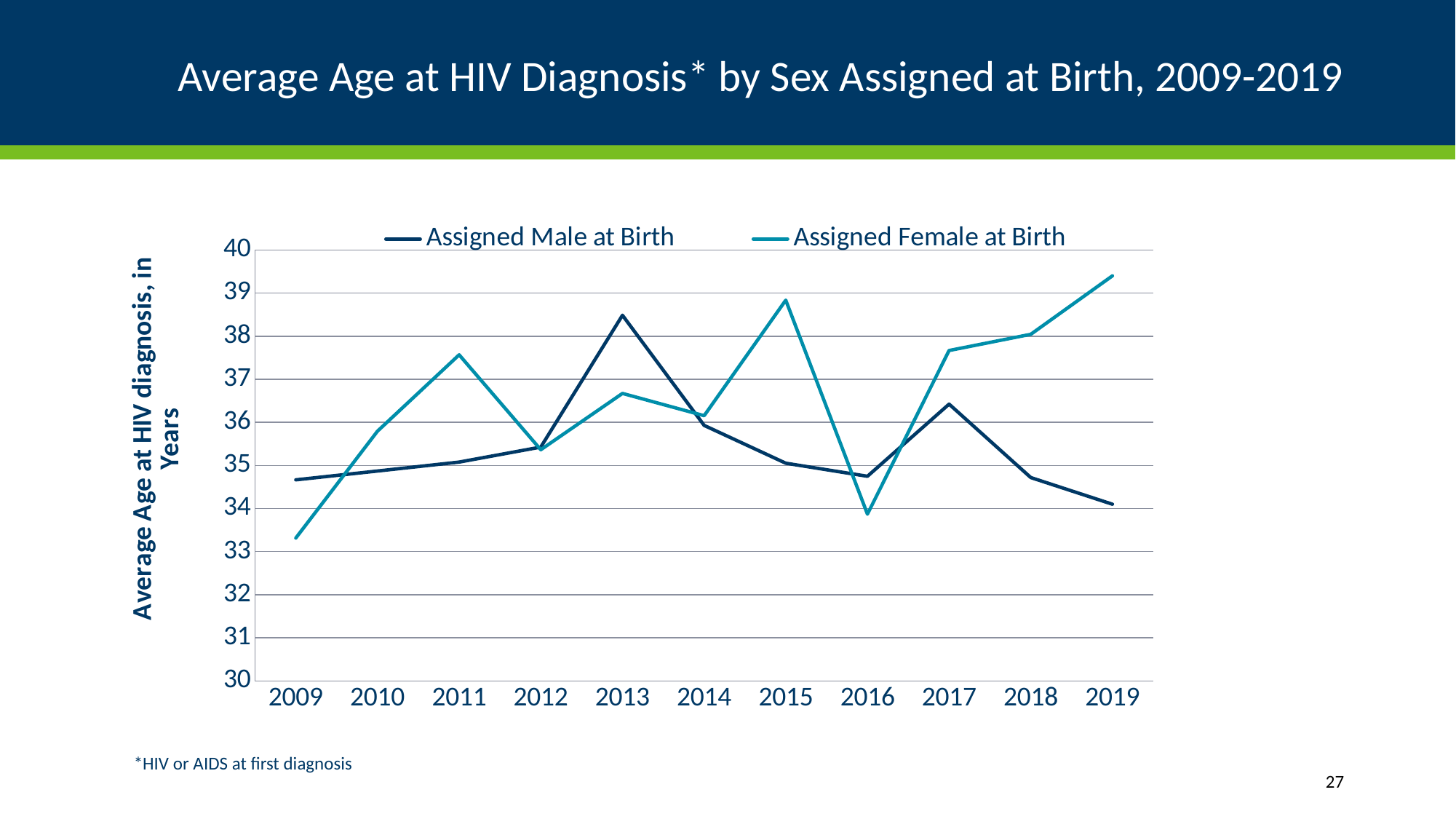
In which year is the average age at diagnosis for Assigned Female at Birth lowest? 2009 Does the Assigned Female at Birth line rise or fall from 2016 to 2019? rise In which year is the average age at diagnosis for Assigned Female at Birth highest? 2019 Is the value for Assigned Female at Birth in 2016 greater or less than 34? less Is the value for Assigned Female at Birth in 2019 greater or less than 39? greater How many years are plotted along the x axis? 11 How many series does the legend list? 2 What kind of chart is shown on the slide? line chart In which year is the average age at diagnosis for Assigned Male at Birth highest? 2013 Is the value for Assigned Male at Birth in 2013 greater or less than 38? greater In 2013, which series has the higher average age at diagnosis? Assigned Male at Birth In 2015, which series has the higher average age at diagnosis? Assigned Female at Birth